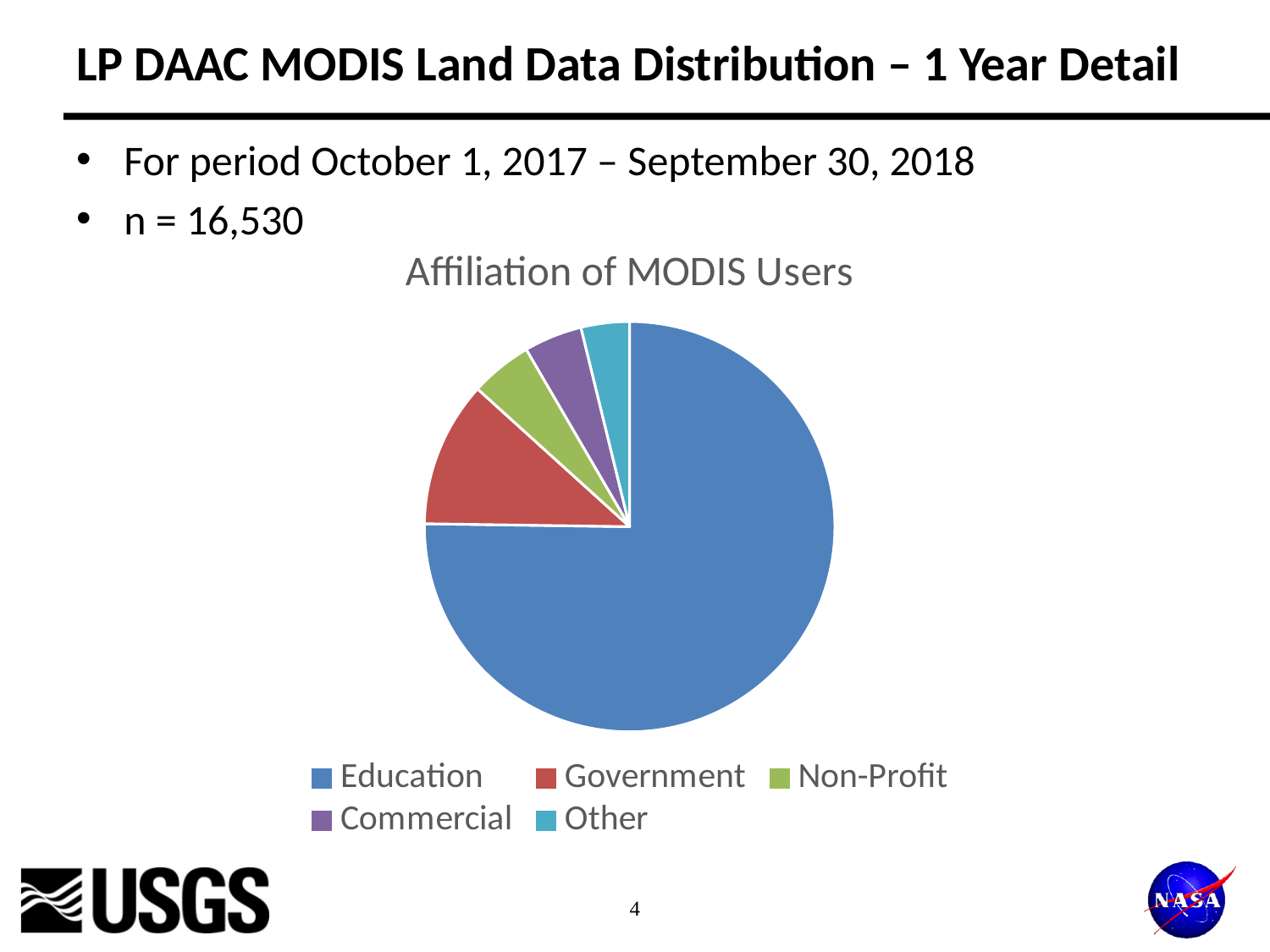
How many categories does the pie chart show? 5 Which is larger, the Education slice or the Government slice? Education Which categories are listed in the legend? Education, Government, Non-Profit, Commercial, Other Does the Education slice make up more or less than half of the pie? more Which category is the second largest slice of the pie? Government Which is larger, the Government slice or the Non-Profit slice? Government Which affiliation has the largest share of MODIS users? Education What colour is the Education slice? blue What kind of chart is shown on the slide? pie chart What is the title of the chart? Affiliation of MODIS Users